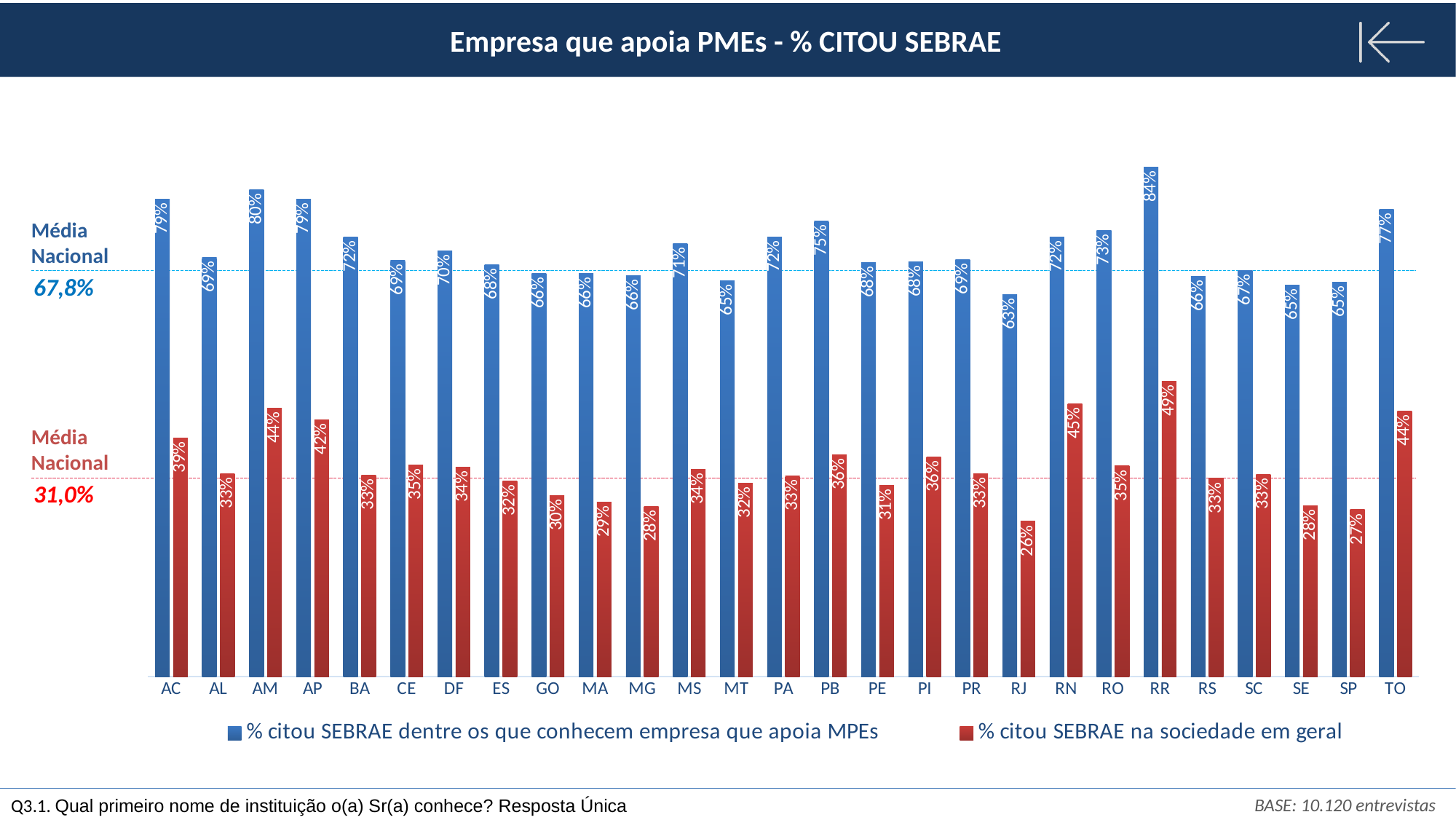
What is the value for RR in the '% citou SEBRAE dentre os que conhecem empresa que apoia MPEs' series? 84% What is the difference between the two series values for TO? 33 percentage points Which state has the highest value in the '% citou SEBRAE dentre os que conhecem empresa que apoia MPEs' series? RR How many states are shown on the x axis? 27 What is the 'Média Nacional' value shown for the blue series? 67,8% How many series does the legend list? 2 What kind of chart is shown on the slide? Bar chart What is the 'Média Nacional' value shown for the red series? 31,0% Which state has the lowest value in the '% citou SEBRAE na sociedade em geral' series? RJ Which is larger: the '% citou SEBRAE na sociedade em geral' value for RN or for AM? RN What is the value for RJ in the '% citou SEBRAE na sociedade em geral' series? 26% What is the value for PB in the '% citou SEBRAE dentre os que conhecem empresa que apoia MPEs' series? 75%